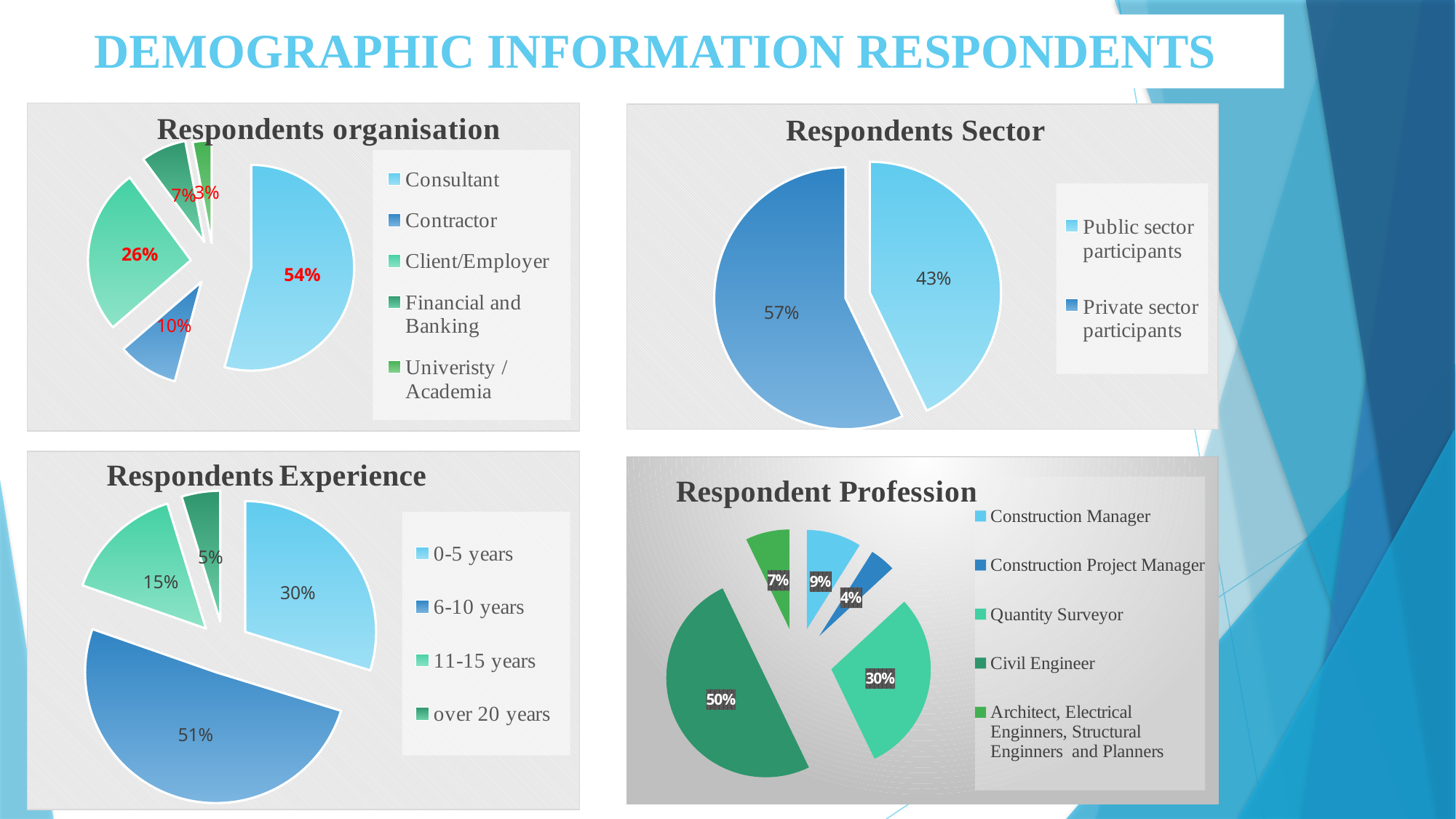
What type of chart is the Respondent Profession chart? Pie chart In the Respondents Sector chart, which is larger: Public sector participants or Private sector participants? Private sector participants In the Respondents Experience chart, what share of respondents have 6-10 years of experience? 51% In the Respondents Experience chart, which experience group has the largest share? 6-10 years In the Respondent Profession chart, what share of respondents are Civil Engineers? 50% In the Respondent Profession chart, which profession has the smallest share? Construction Project Manager In the Respondents Experience chart, what is the difference between the 0-5 years share and the 11-15 years share? 15% In the Respondents organisation chart, what share of respondents are Consultants? 54% How many categories does the Respondents Sector chart show? 2 In the Respondents organisation chart, what is the difference between the Client/Employer share and the Contractor share? 16% In the Respondents organisation chart, which category has the smallest share? Univeristy / Academia In the Respondents Sector chart, what percentage are Private sector participants? 57%